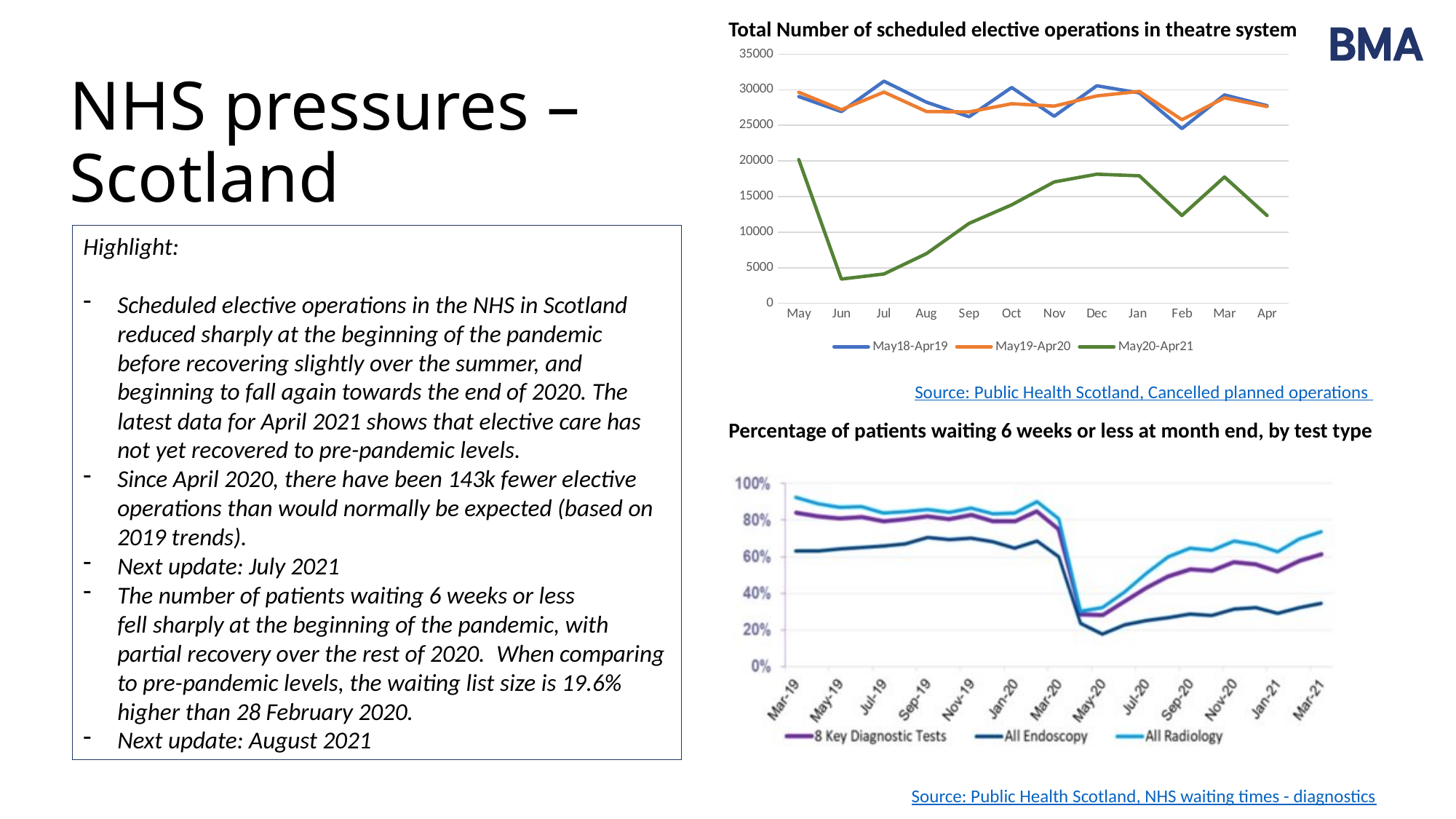
In the top chart, 'Total Number of scheduled elective operations in theatre system', is the May20-Apr21 value for Jun greater or less than 5000? less How many series does the legend of the bottom chart, 'Percentage of patients waiting 6 weeks or less at month end, by test type', list? 3 What kind of chart is the top chart, 'Total Number of scheduled elective operations in theatre system'? line chart In the bottom chart, 'Percentage of patients waiting 6 weeks or less at month end, by test type', is the All Endoscopy value for May-20 greater or less than 20%? less In the bottom chart, 'Percentage of patients waiting 6 weeks or less at month end, by test type', at which month label is the All Endoscopy series lowest? May-20 In the top chart, 'Total Number of scheduled elective operations in theatre system', is the May20-Apr21 value for Dec greater or less than 15000? greater In the bottom chart, 'Percentage of patients waiting 6 weeks or less at month end, by test type', which series is higher at Mar-21: All Radiology or All Endoscopy? All Radiology In the top chart, 'Total Number of scheduled elective operations in theatre system', in which month is the May20-Apr21 series lowest? Jun How many months are shown on the x axis of the top chart, 'Total Number of scheduled elective operations in theatre system'? 12 In the top chart, 'Total Number of scheduled elective operations in theatre system', does the May20-Apr21 series rise or fall from Jun to Dec? rise In the top chart, 'Total Number of scheduled elective operations in theatre system', which series has the lowest values across the year? May20-Apr21 How many series does the legend of the top chart, 'Total Number of scheduled elective operations in theatre system', list? 3